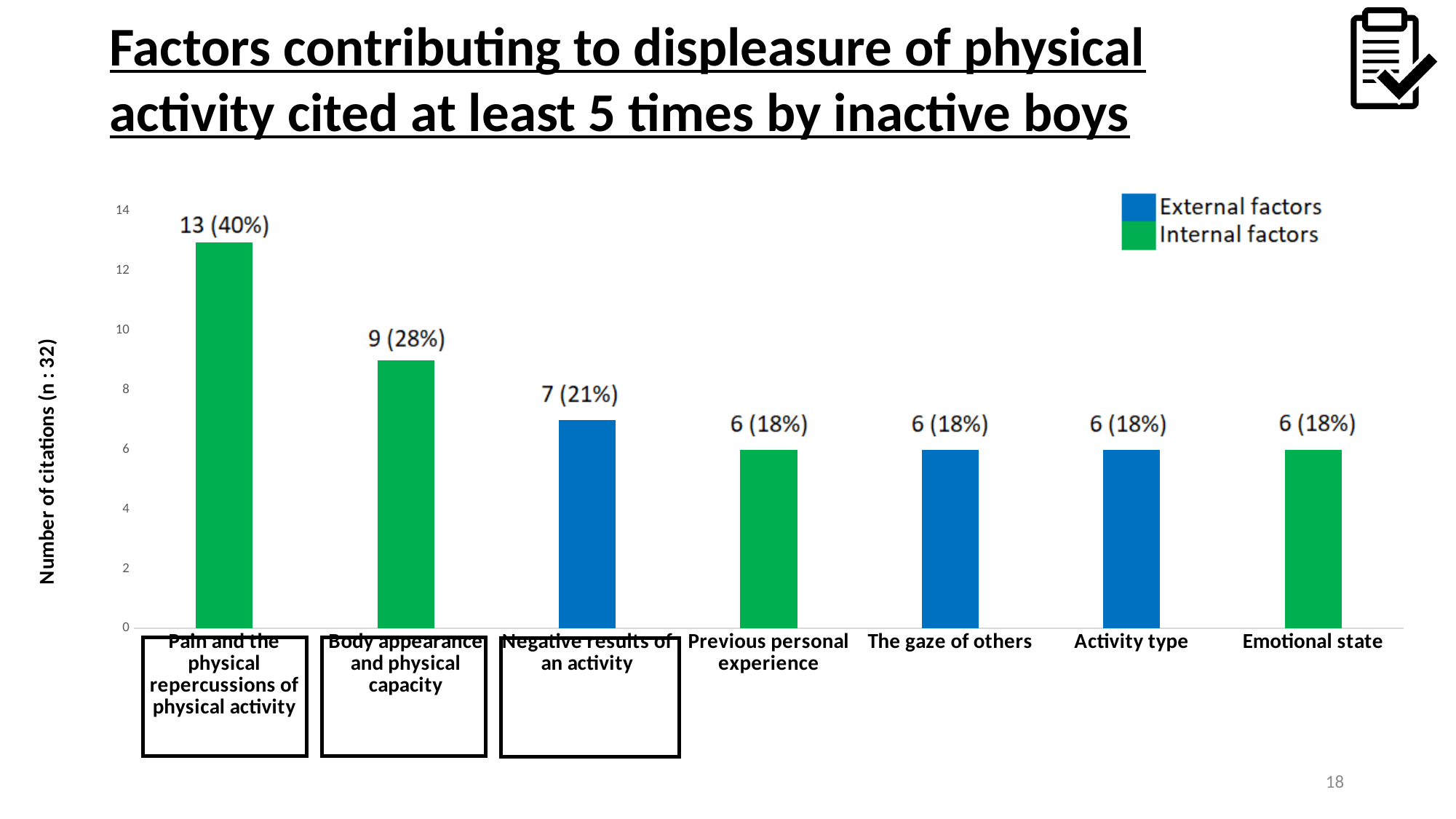
Which has more citations, 'Body appearance and physical capacity' or 'Negative results of an activity'? Body appearance and physical capacity What is the number of citations for 'Negative results of an activity'? 7 (21%) What kind of chart is shown on the slide? Bar chart What is the difference in citations between 'Negative results of an activity' and 'Activity type'? 1 Is the value for 'Pain and the physical repercussions of physical activity' greater or less than 12? greater What is the number of citations for 'Body appearance and physical capacity'? 9 (28%) What is the difference in citations between 'Pain and the physical repercussions of physical activity' and 'Body appearance and physical capacity'? 4 How many series does the legend list? 2 Which colour represents External factors in the legend? Blue How many factors are shown on the chart? 7 What is the number of citations for 'The gaze of others'? 6 (18%) Which factor has the highest number of citations? Pain and the physical repercussions of physical activity